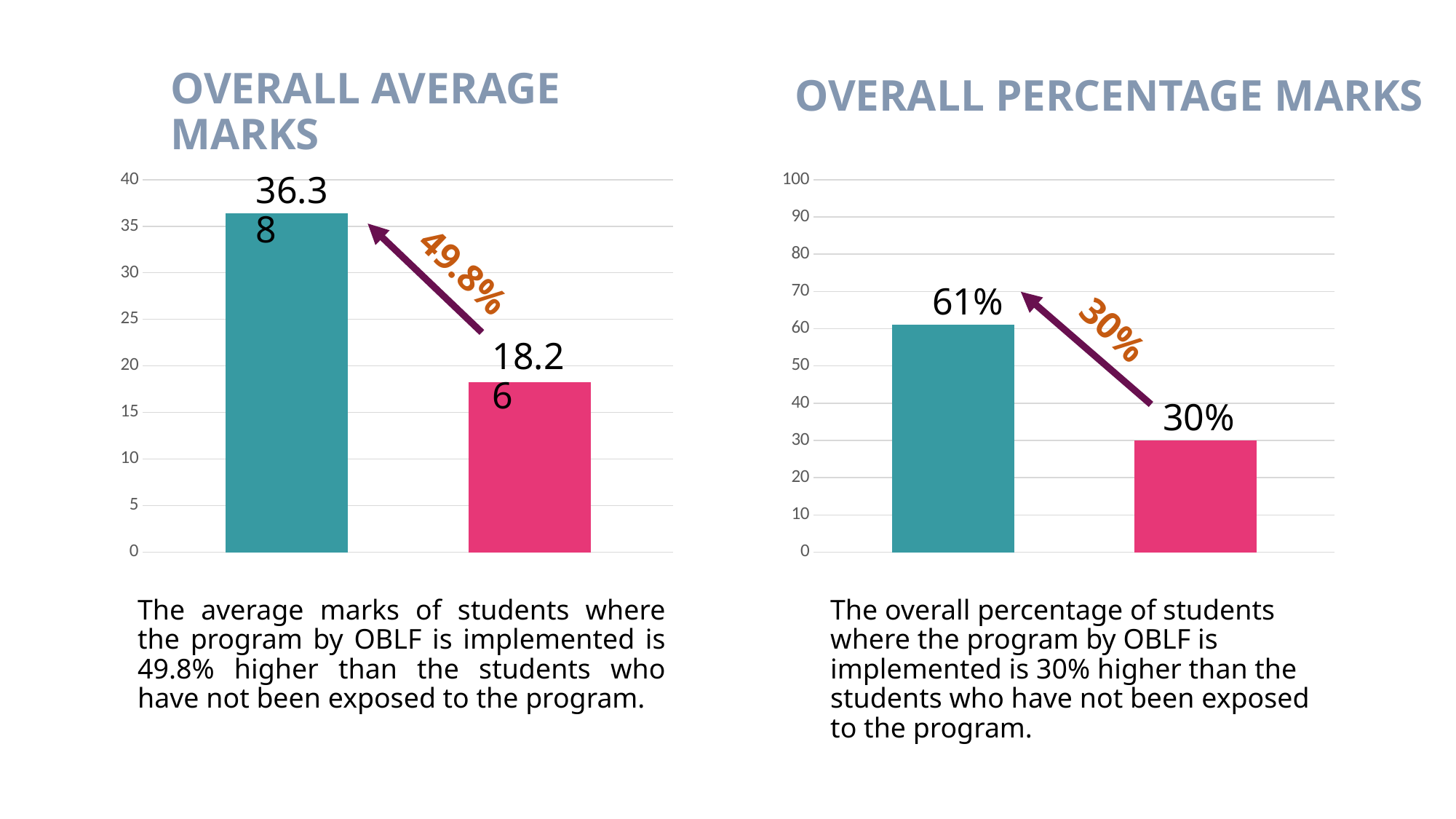
In the OVERALL PERCENTAGE MARKS chart, what value is labelled on the teal (left) bar? 61% What type of chart is the OVERALL PERCENTAGE MARKS chart? bar chart How many bars are plotted in the OVERALL AVERAGE MARKS chart? 2 In the OVERALL AVERAGE MARKS chart, what value is labelled on the pink (right) bar? 18.26 In the OVERALL AVERAGE MARKS chart, what is the difference between the teal bar and the pink bar? 18.12 In the OVERALL PERCENTAGE MARKS chart, what is the difference between the teal bar and the pink bar? 31% In the OVERALL PERCENTAGE MARKS chart, what value is labelled on the pink (right) bar? 30% In the OVERALL AVERAGE MARKS chart, what value is labelled on the teal (left) bar? 36.38 In the OVERALL AVERAGE MARKS chart, which bar is taller, the teal one or the pink one? the teal one What percentage increase is written next to the arrow in the OVERALL AVERAGE MARKS chart? 49.8% In the OVERALL PERCENTAGE MARKS chart, is the value of the teal bar greater or less than 50? greater In the OVERALL PERCENTAGE MARKS chart, which bar is the lowest? the pink (right) bar